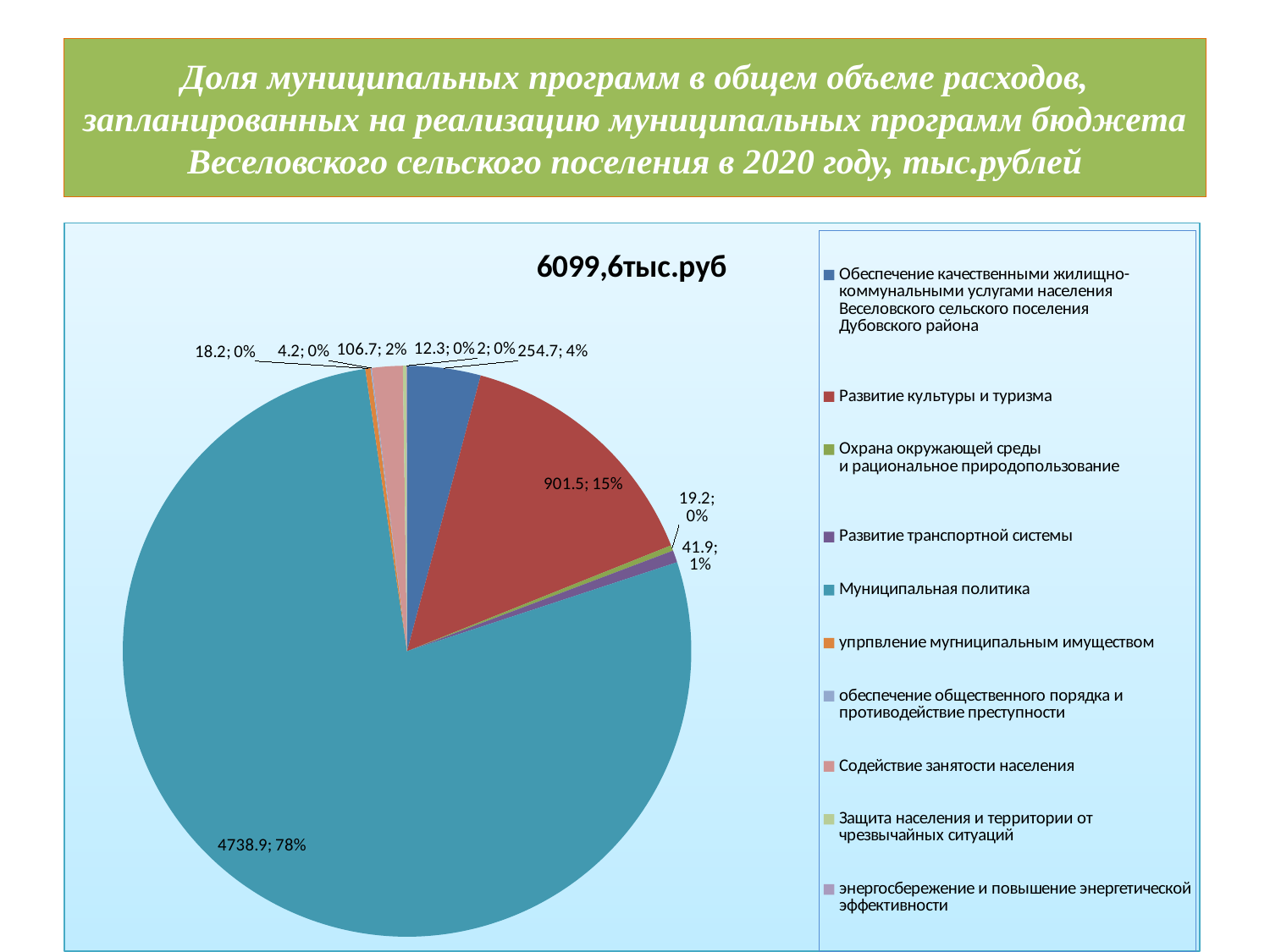
What share of the pie does "Развитие культуры и туризма" take? 15% How many entries does the legend of the pie chart list? 10 What kind of chart is shown on the slide? pie chart Which category has the largest slice of the pie? Муниципальная политика What is the difference between the values for "Муниципальная политика" and "Развитие культуры и туризма"? 3837.4 What value is labelled for "Обеспечение качественными жилищно-коммунальными услугами населения Веселовского сельского поселения Дубовского района"? 254.7 What is the title printed above the pie chart? 6099,6тыс.руб What value is labelled for "Содействие занятости населения"? 106.7 What value is labelled for the slice "Муниципальная политика"? 4738.9 Which is larger: the value for "Развитие культуры и туризма" or the value for "Обеспечение качественными жилищно-коммунальными услугами населения"? Развитие культуры и туризма What share of the pie does "Муниципальная политика" take? 78% What value is labelled for "Развитие культуры и туризма"? 901.5